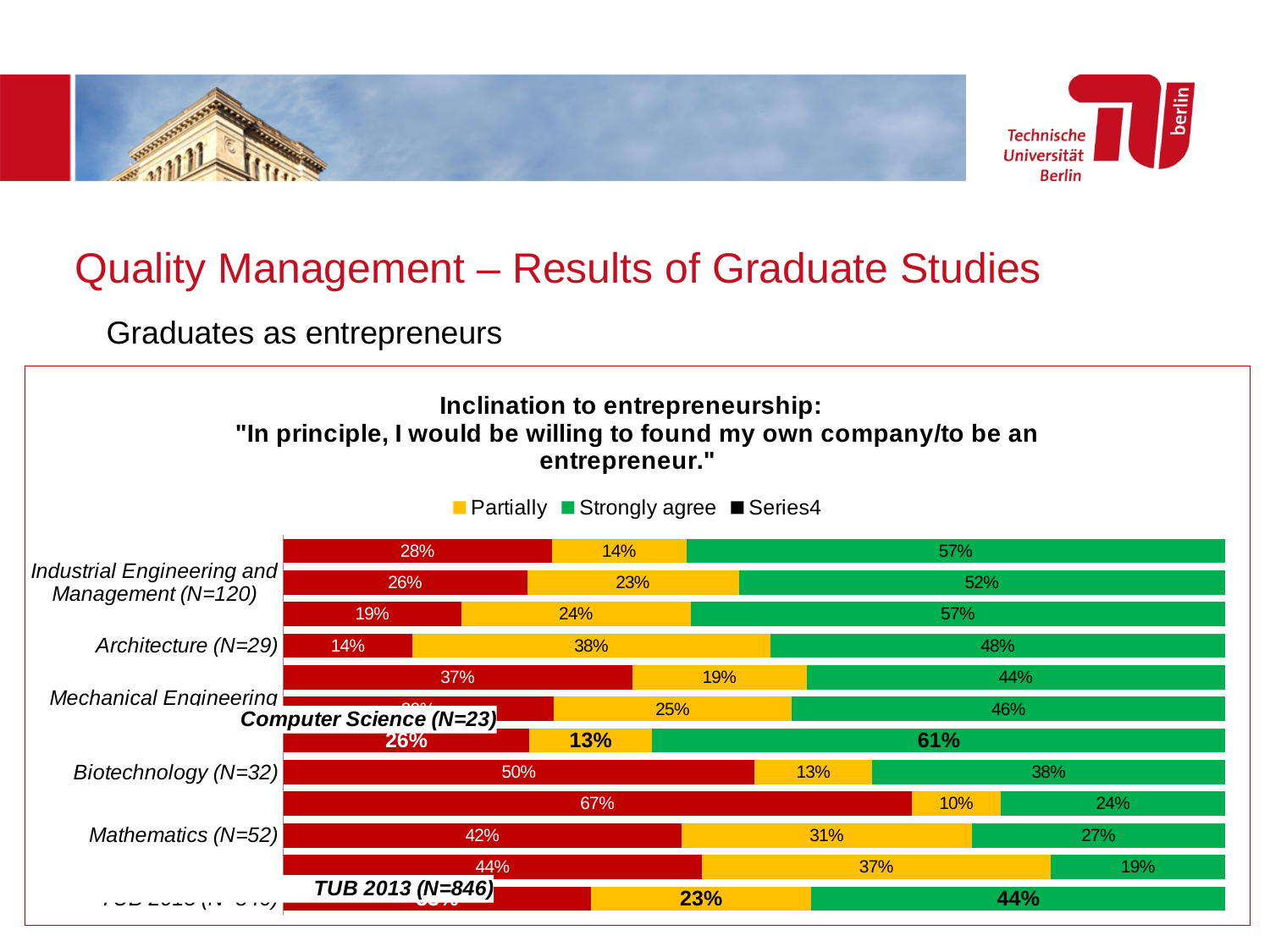
What is the 'Strongly agree' value for Biotechnology (N=32)? 38% What colour represents the 'Strongly agree' series in the chart? Green What is the 'Strongly agree' value for TUB 2013 (N=846)? 44% What kind of chart is shown on the slide? Bar chart What is the difference between the 'Partially' values for Architecture (N=29) and Mathematics (N=52)? 7 percentage points What is the difference between the 'Strongly agree' values for Computer Science (N=23) and TUB 2013 (N=846)? 17 percentage points How many series does the chart legend list? 3 What is the first line of the chart's title? Inclination to entrepreneurship: What is the 'Strongly agree' value for Architecture (N=29)? 48% What is the 'Partially' value for Mathematics (N=52)? 31% What is the 'Partially' value for Computer Science (N=23)? 13% Which has a higher 'Strongly agree' value, Computer Science (N=23) or Biotechnology (N=32)? Computer Science (N=23)